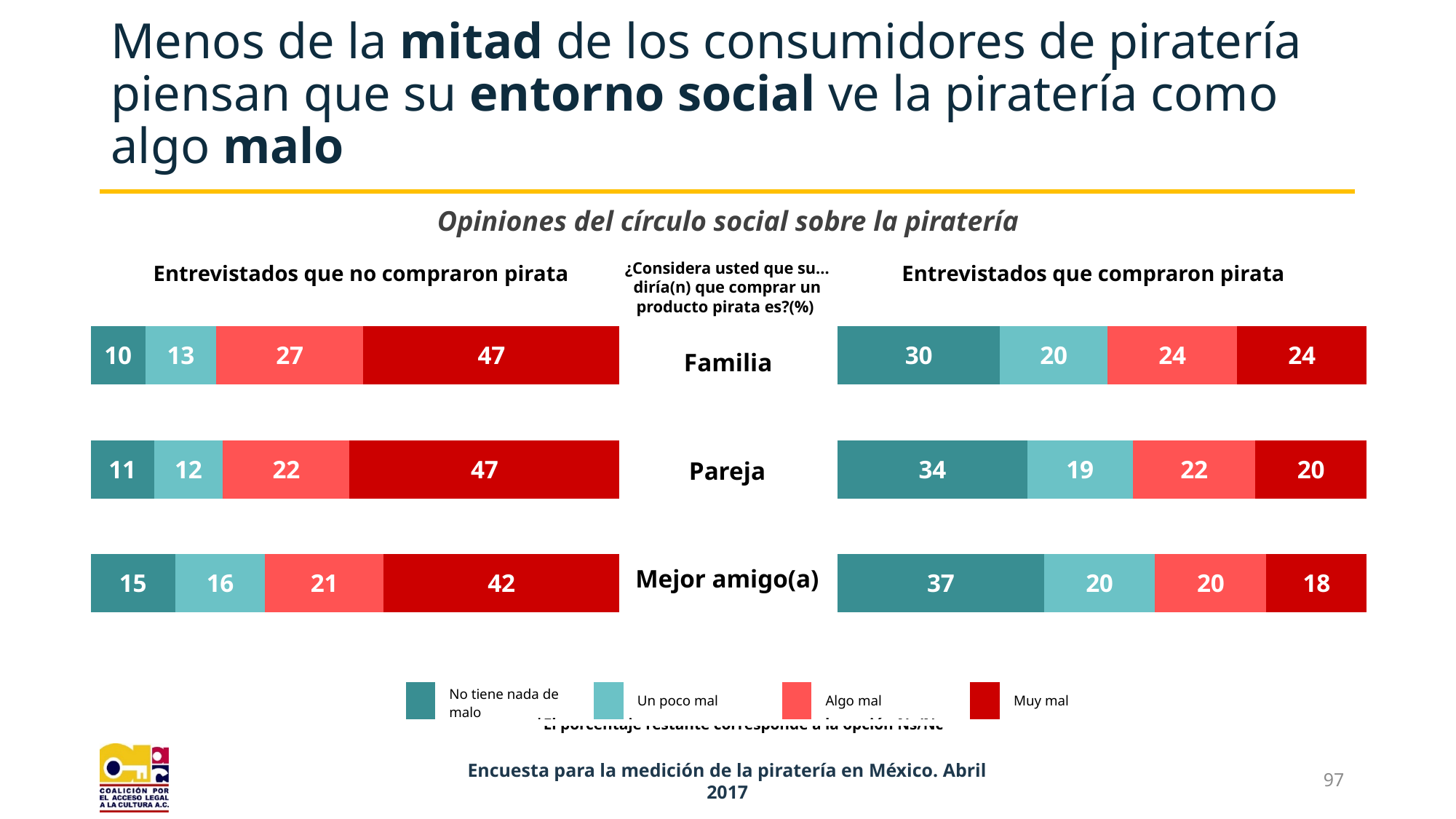
Which is larger: the 'No tiene nada de malo' value for Familia in 'Entrevistados que compraron pirata' or in 'Entrevistados que no compraron pirata'? Entrevistados que compraron pirata In the chart 'Entrevistados que no compraron pirata', what is the difference between the 'Muy mal' values for Familia and Mejor amigo(a)? 5 In the chart 'Entrevistados que compraron pirata', what is the value of 'Un poco mal' for Pareja? 19 In the chart 'Entrevistados que no compraron pirata', what is the value of 'Muy mal' for Familia? 47 How many series does the legend list for these charts? 4 In the chart 'Entrevistados que no compraron pirata', what is the total of the stacked bar for Familia? 97 In the chart 'Entrevistados que compraron pirata', which category has the lowest value for 'Muy mal'? Mejor amigo(a) How many categories are shown in the chart 'Entrevistados que compraron pirata'? 3 In the chart 'Entrevistados que compraron pirata', what is the total of the stacked bar for Pareja? 95 In the chart 'Entrevistados que compraron pirata', what is the value of 'No tiene nada de malo' for Mejor amigo(a)? 37 What kind of chart is 'Entrevistados que no compraron pirata'? Stacked bar chart In the chart 'Entrevistados que no compraron pirata', which category has the highest value for 'No tiene nada de malo'? Mejor amigo(a)